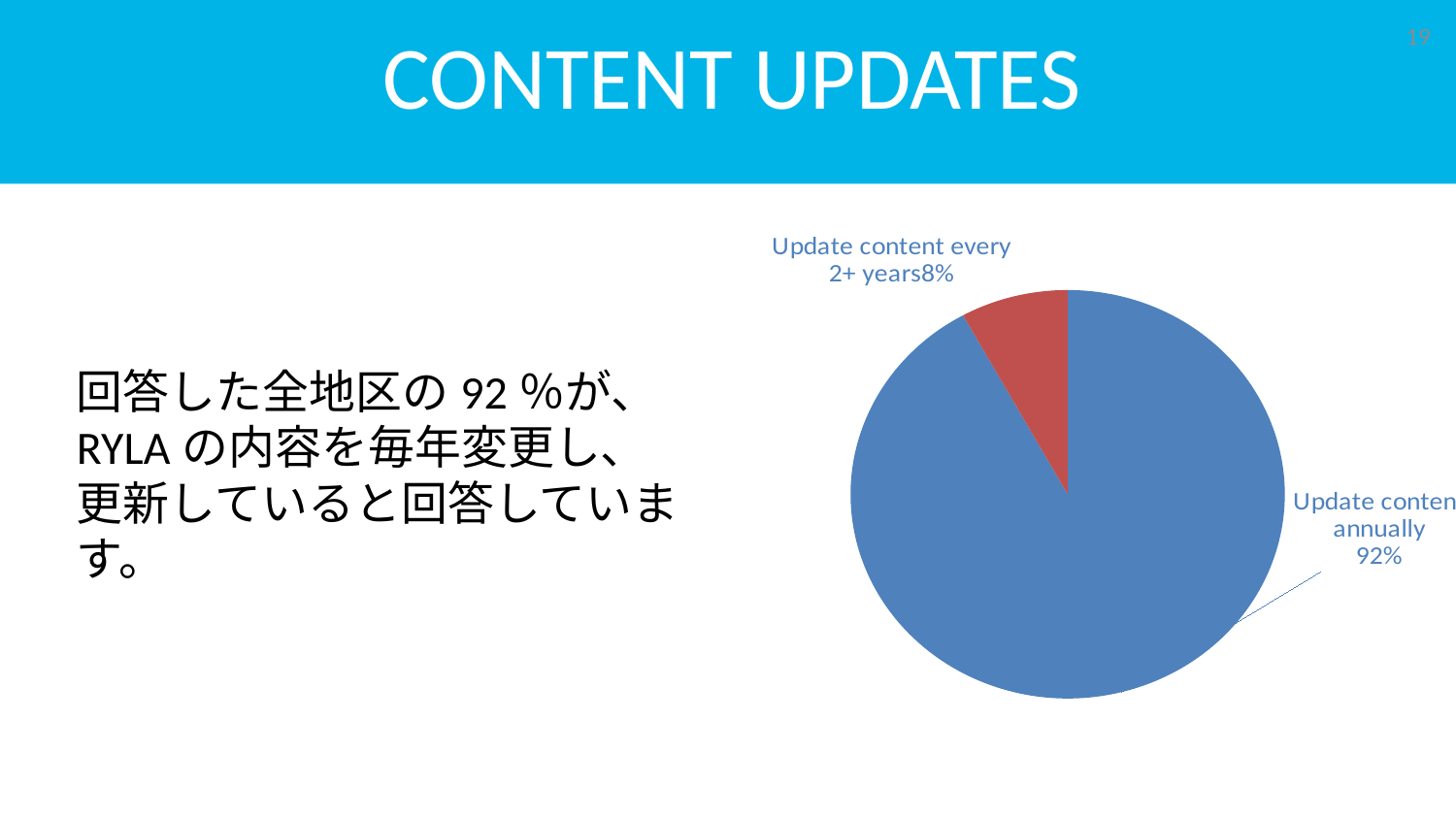
What colour is the "Update content every 2+ years" slice? red What share of the pie is labelled "Update content every 2+ years"? 8% What is the difference in percentage points between the "Update content annually" slice and the "Update content every 2+ years" slice? 84 What colour is the "Update content annually" slice? blue How many slices does the pie chart have? 2 Which slice of the pie is the smallest? Update content every 2+ years What kind of chart is shown on the slide? pie chart Which slice of the pie is the largest? Update content annually Which is larger: the share for "Update content annually" or the share for "Update content every 2+ years"? Update content annually What share of the pie is labelled "Update content annually"? 92%